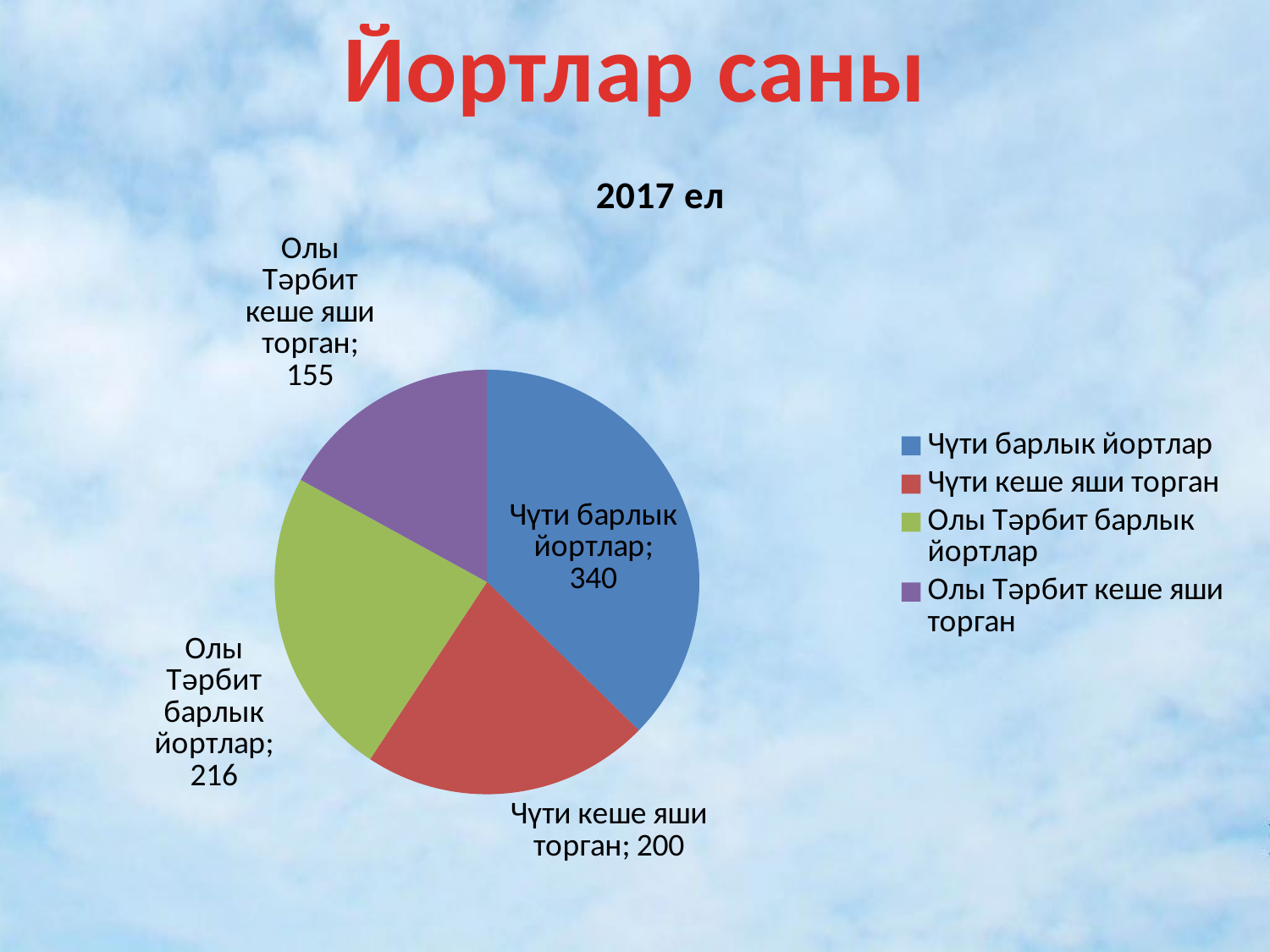
What is the value for Чүти кеше яши торган? 200 What colour is the slice for Олы Тәрбит барлык йортлар? Green How many slices does the pie chart have? 4 What is the title of the chart? 2017 ел Which category has the smallest slice? Олы Тәрбит кеше яши торган What is the value for Чүти барлык йортлар? 340 What is the value for Олы Тәрбит барлык йортлар? 216 Which category has the largest slice? Чүти барлык йортлар What is the value for Олы Тәрбит кеше яши торган? 155 What is the difference between Чүти барлык йортлар and Чүти кеше яши торган? 140 What type of chart is shown on the slide? Pie chart Which is larger, Олы Тәрбит барлык йортлар or Чүти кеше яши торган? Олы Тәрбит барлык йортлар